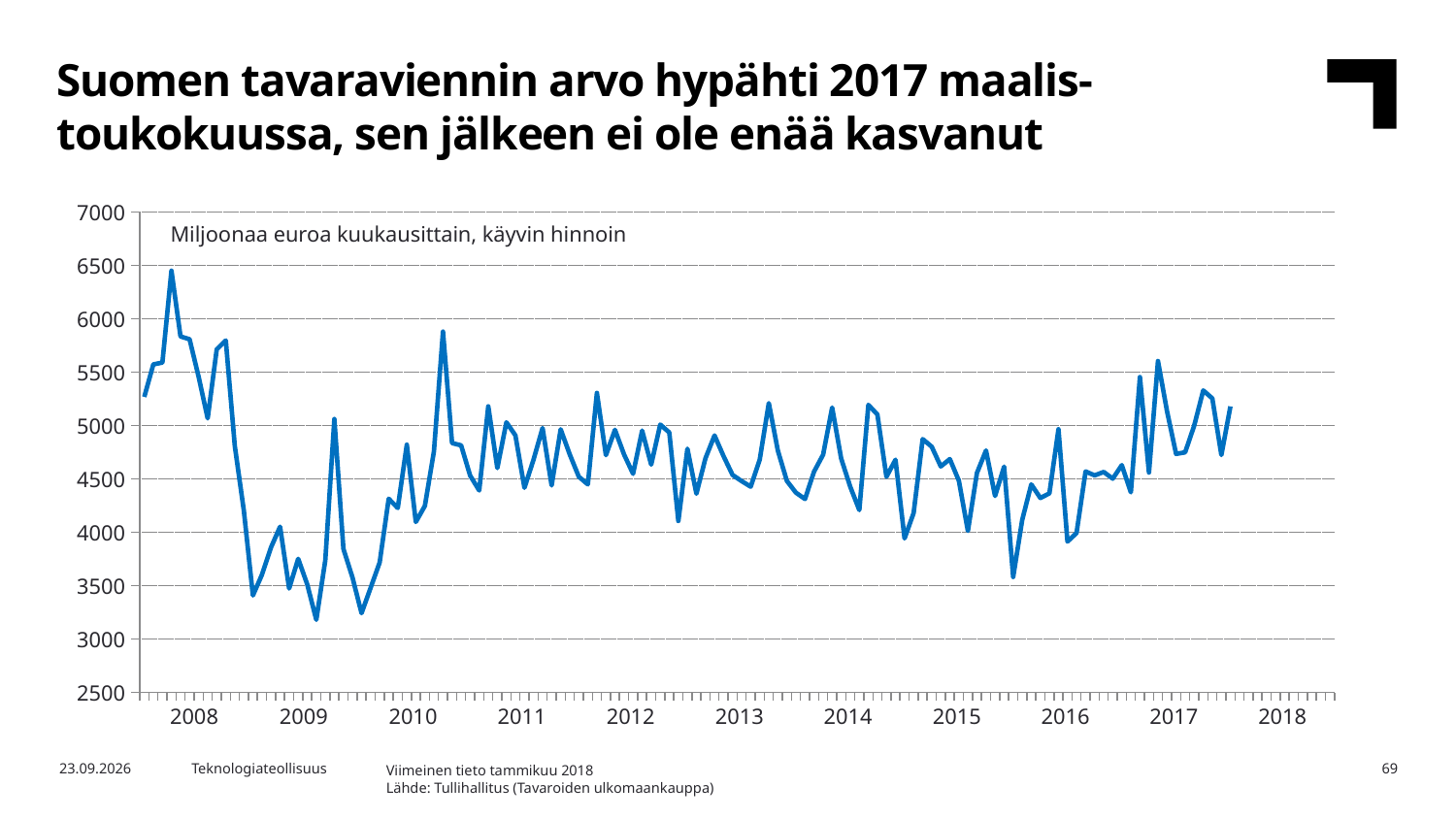
Is the highest value in 2008 greater or less than 6000? greater What unit does the chart's subtitle say the values are in? Miljoonaa euroa kuukausittain, käyvin hinnoin In which year does the line reach its highest point? 2008 Is the last plotted value (January 2018) greater or less than 5000? greater In which year does the line reach its lowest point? 2009 According to the footnote, what is the source of the data? Tullihallitus (Tavaroiden ulkomaankauppa) Is the lowest value in 2015 greater or less than 4000? less What kind of chart is shown on the slide? line chart How many year labels are shown on the x axis? 11 Does the line rise or fall from its 2008 peak to early 2009? fall